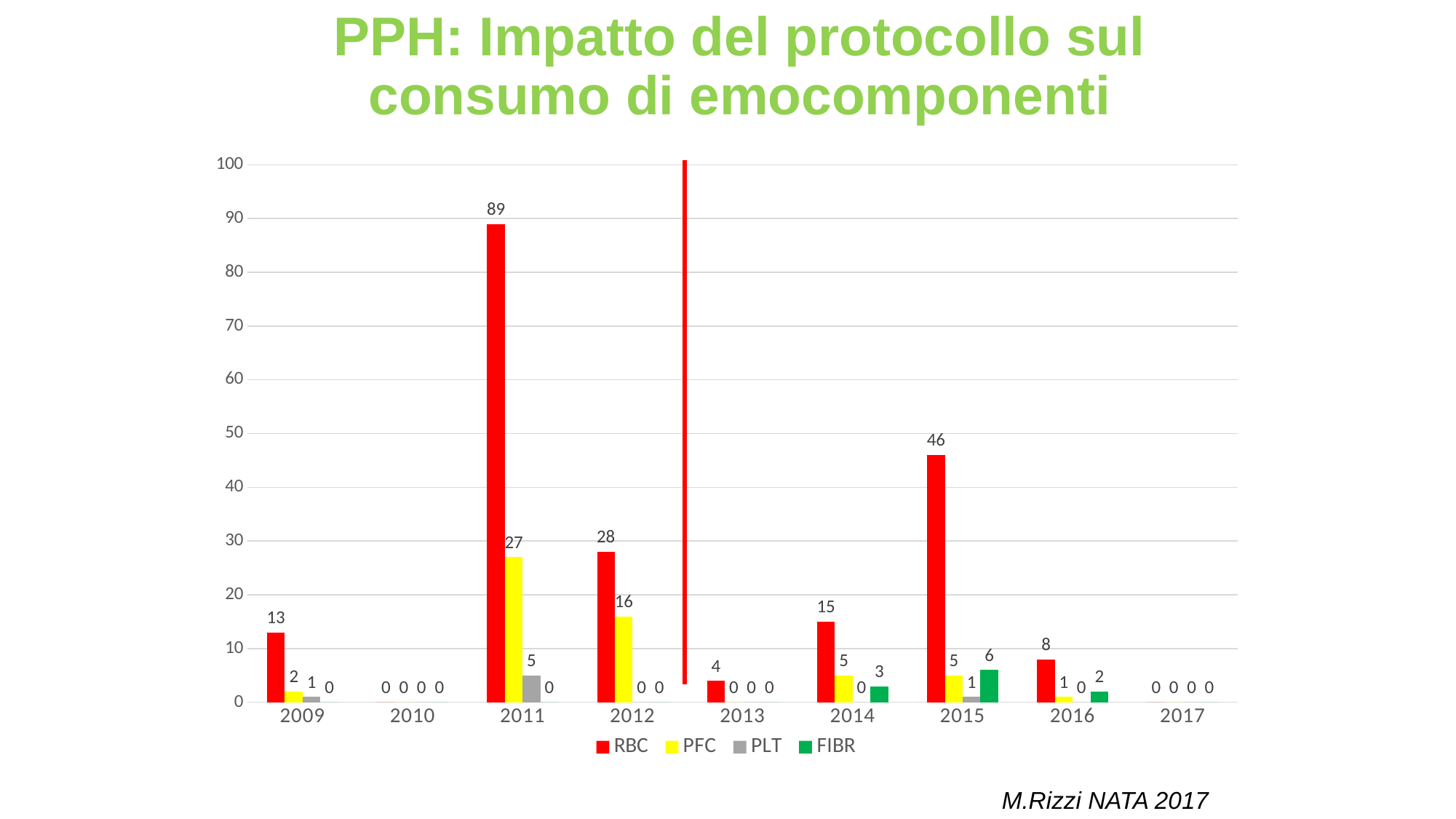
Which is larger, the PFC value for 2011 or the RBC value for 2012? RBC value for 2012 In which year is the RBC value highest? 2011 What is the difference between the RBC values for 2011 and 2015? 43 How many years are shown on the x axis? 9 Which colour represents the FIBR series in the legend? green What is the FIBR value for 2015? 6 What is the PFC value for 2012? 16 What kind of chart is shown on the slide? bar chart What is the RBC value for 2011? 89 What is the total of all four series for 2014? 23 How many series does the legend list? 4 What is the PLT value for 2011? 5